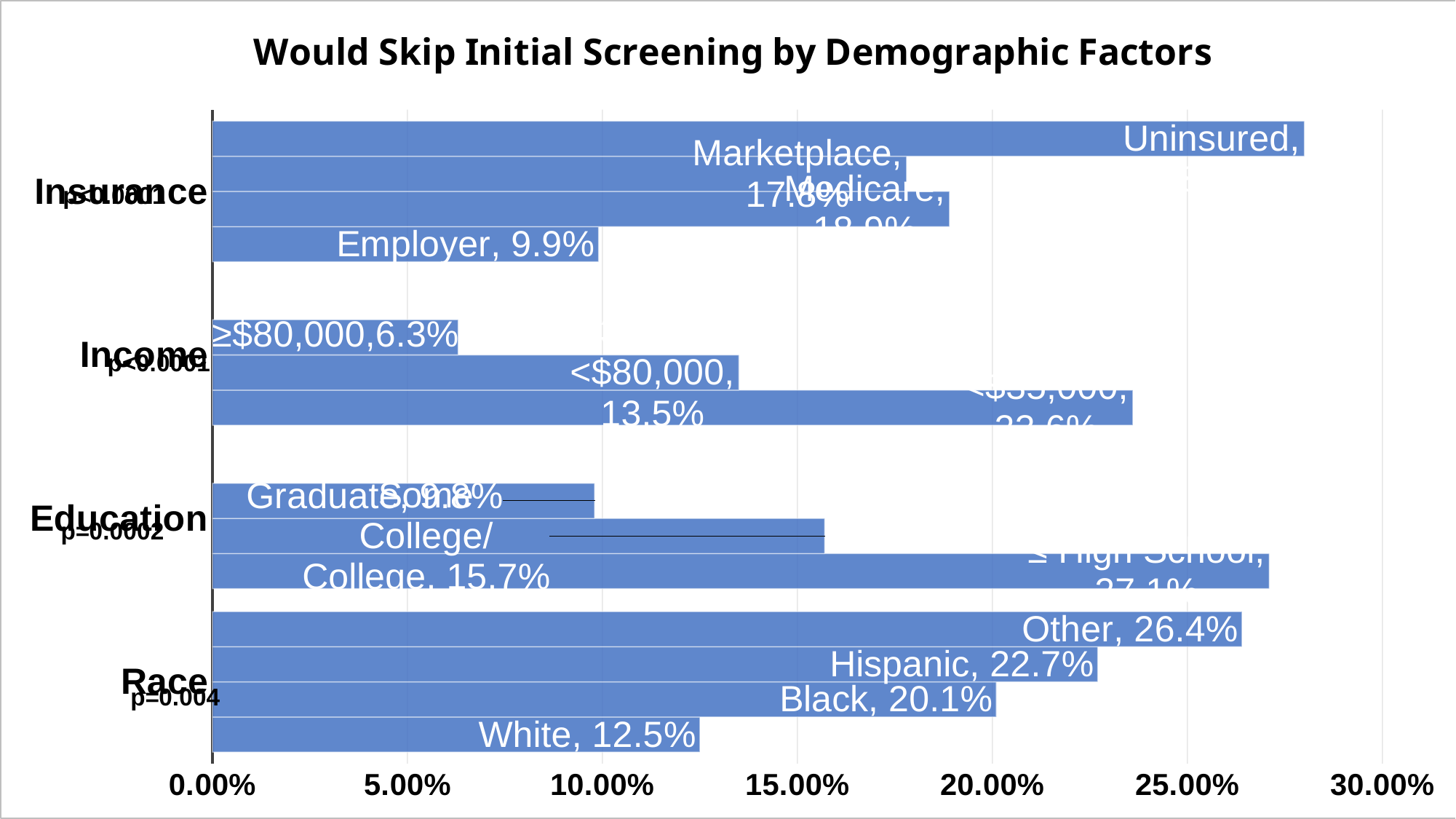
Which category in the Race group has the highest value? Other What is the title of the chart? Would Skip Initial Screening by Demographic Factors What is the value for Other in the Race group? 26.4% What is the value for White in the Race group? 12.5% What is the value for Employer in the Insurance group? 9.9% Which has a larger value, Black or Hispanic? Hispanic What kind of chart is shown on the slide? bar chart Is the value for Uninsured greater or less than 25.00%? greater Which category in the Race group has the lowest value? White What is the difference between the values for Other and White in the Race group? 13.9% What is the value for Hispanic in the Race group? 22.7% What is the value for the ≥$80,000 income category? 6.3%